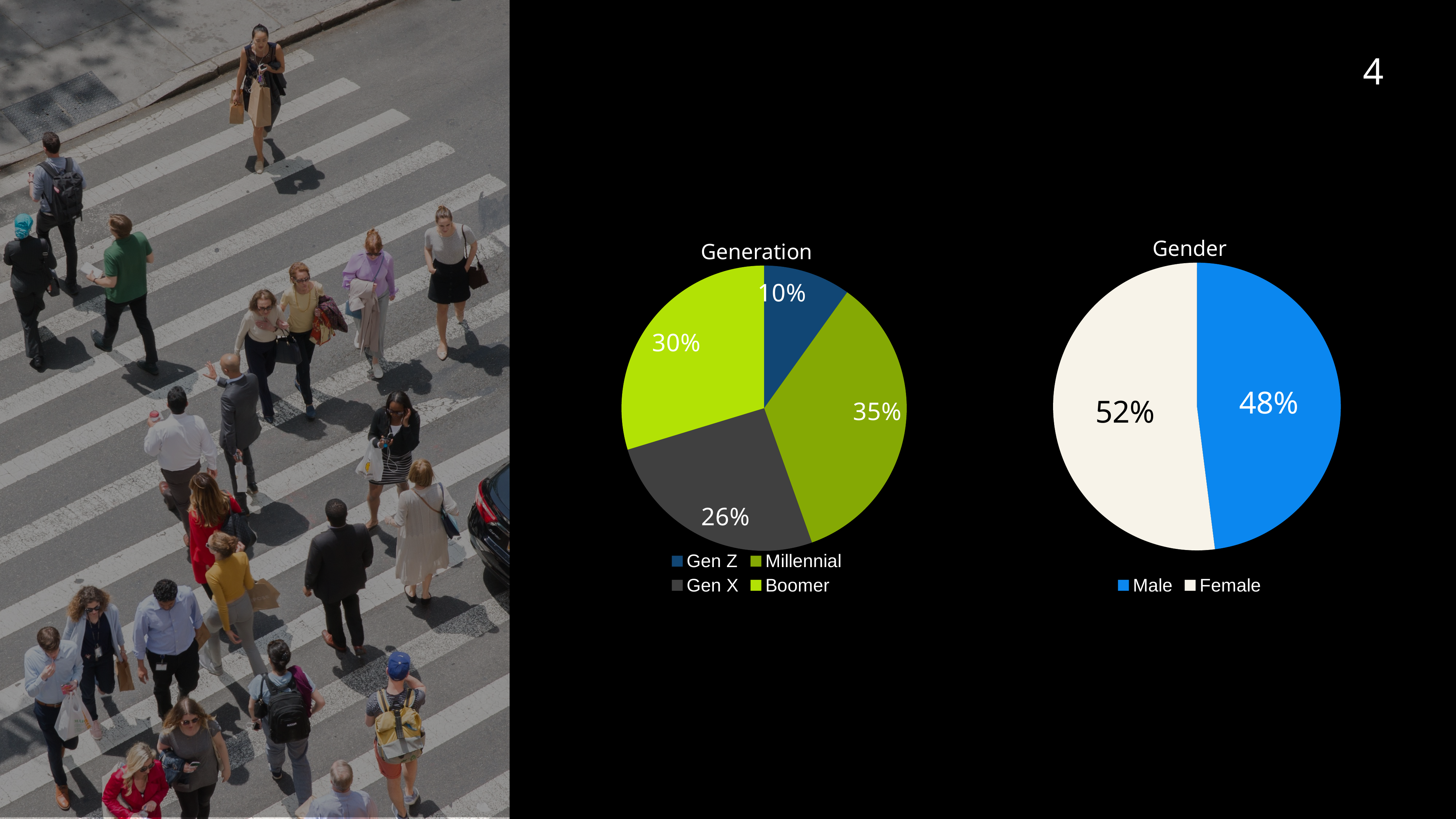
In the Generation chart, what is the difference in percentage points between Millennial and Gen Z? 25 In the Generation chart, which is larger, Boomer or Gen X? Boomer In the Generation chart, what share is Gen X? 26% In the Generation chart, what share is Boomer? 30% In the Generation chart, what share is Millennial? 35% In the Gender chart, what share is Male? 48% In the Generation chart, which generation has the smallest share? Gen Z In the Gender chart, what share is Female? 52% How many categories does the Generation chart show? 4 In the Generation chart, which generation has the largest share? Millennial In the Generation chart, what share is Gen Z? 10% What type of chart is the Gender chart? Pie chart